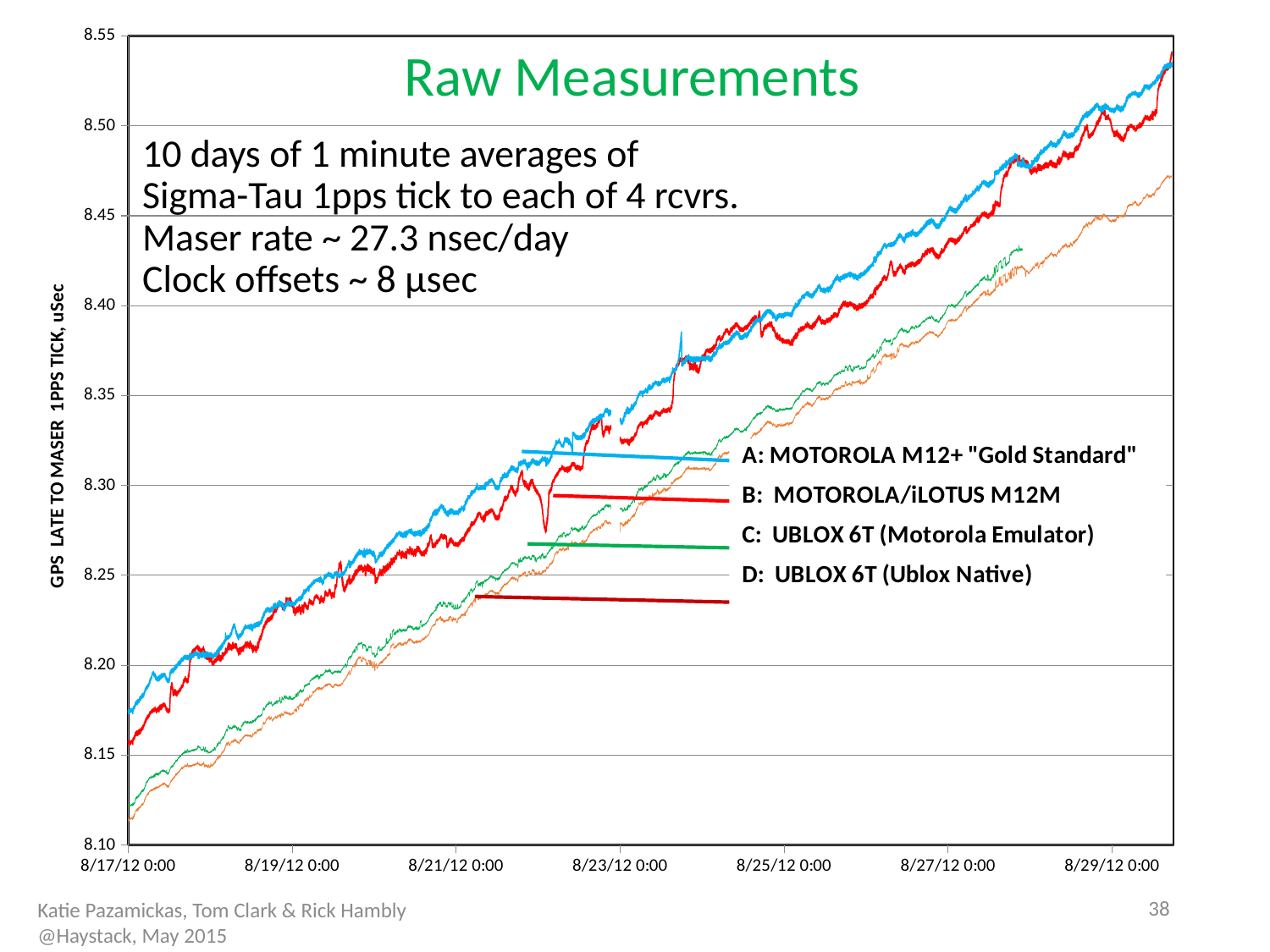
What kind of chart is shown on the slide? line chart Do the plotted values rise or fall from 8/17/12 to 8/29/12? rise Is the value for series D (UBLOX 6T Ublox Native) at 8/29/12 0:00 greater or less than 8.50? less How many series does the legend list? 4 Is the value for series D (UBLOX 6T Ublox Native) at 8/17/12 0:00 greater or less than 8.15? less At 8/17/12 0:00, which series has the higher value, A (MOTOROLA M12+) or D (UBLOX 6T Ublox Native)? A (MOTOROLA M12+) Is the value for series B (MOTOROLA/iLOTUS M12M) at 8/23/12 0:00 greater or less than 8.30? greater What is the title of the chart? Raw Measurements What is the label of the y axis? GPS LATE TO MASER 1PPS TICK, uSec Which series has the lowest value at 8/17/12 0:00? D: UBLOX 6T (Ublox Native)